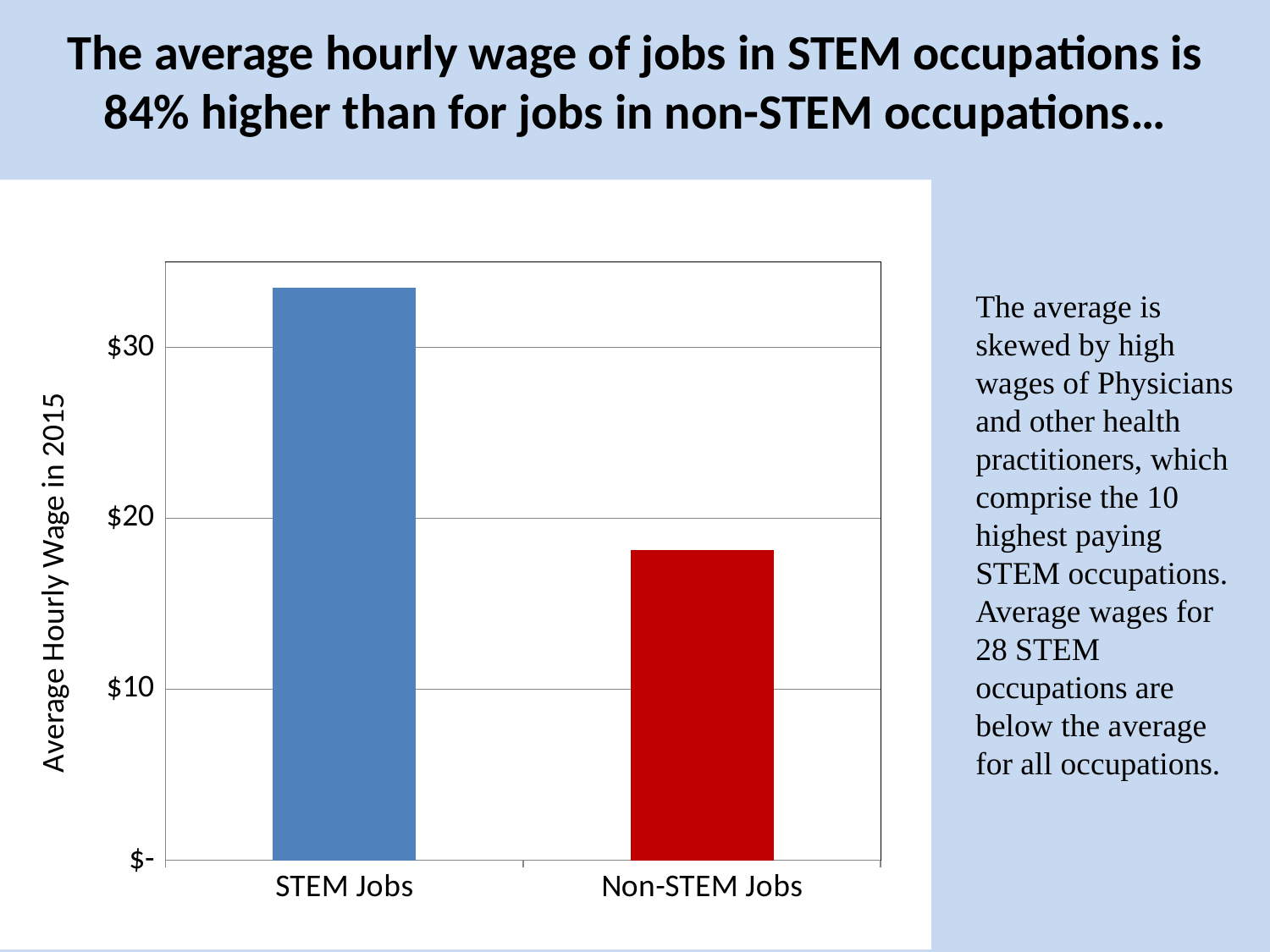
Which category has the highest average hourly wage in the chart? STEM Jobs What colour is the bar for Non-STEM Jobs? red What kind of chart is shown on the slide? bar chart Which is larger, the average hourly wage for STEM Jobs or for Non-STEM Jobs? STEM Jobs Is the value for STEM Jobs greater or less than $30? greater What is the label on the y axis of the chart? Average Hourly Wage in 2015 How many categories are plotted on the x axis of the chart? 2 Do the bar values rise or fall from left to right along the x axis? fall Is the value for Non-STEM Jobs greater or less than $10? greater Is the value for Non-STEM Jobs greater or less than $20? less Which category has the lowest average hourly wage in the chart? Non-STEM Jobs